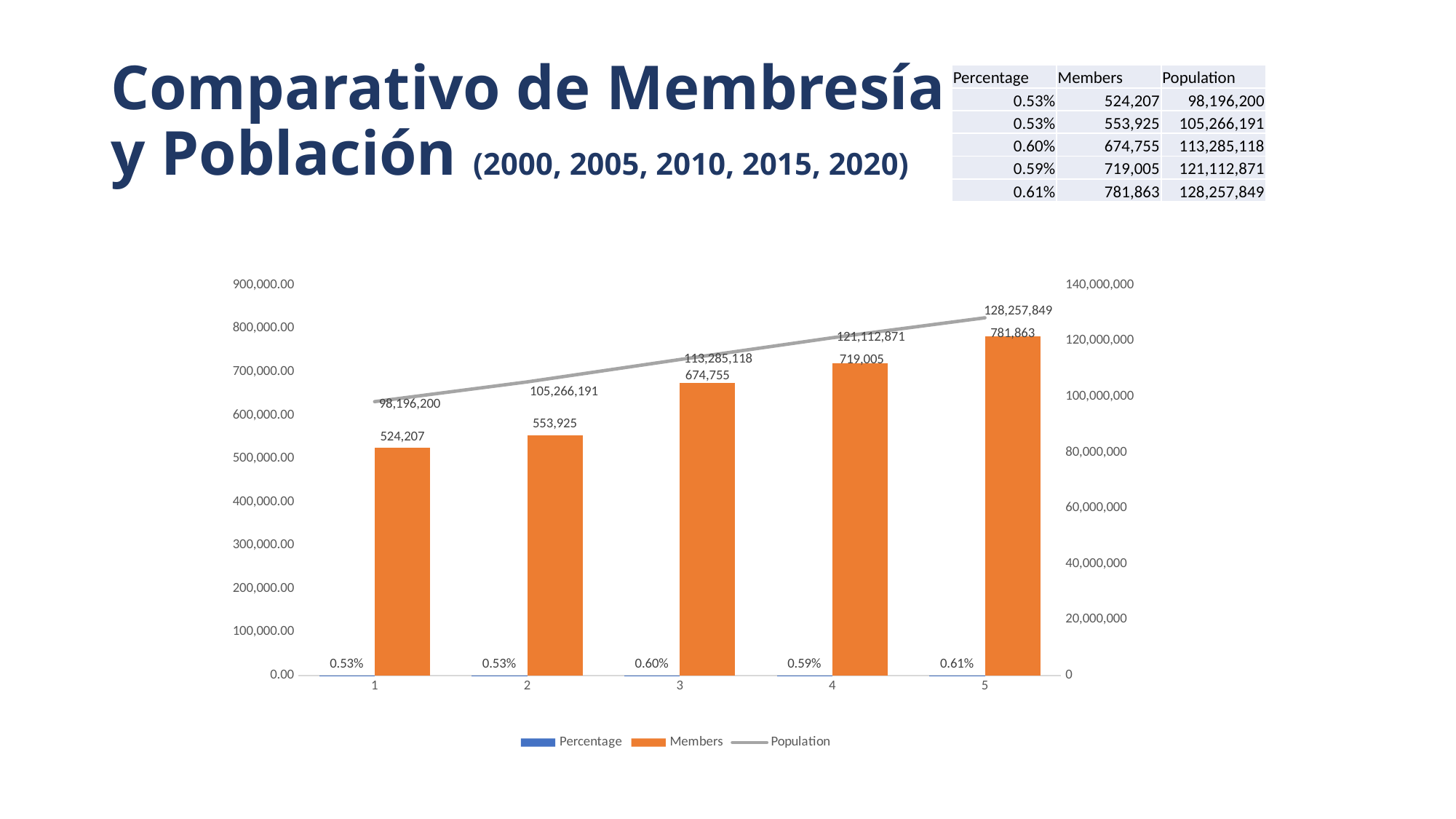
How many categories are shown on the x axis? 5 Is the Members value for category 2 greater or less than 600,000.00? less How many series does the legend list? 3 Which is larger, the Members value for category 3 or for category 4? category 4 Which category has the lowest Population value? 1 What is the Members value for category 1? 524,207 What is the difference in Members between category 5 and category 1? 257,656 What is the Population value for category 5? 128,257,849 Does the Population line rise or fall from category 1 to category 5? rise Which category has the highest Members value? 5 What is the Population value for category 3? 113,285,118 What is the Percentage value for category 5? 0.61%